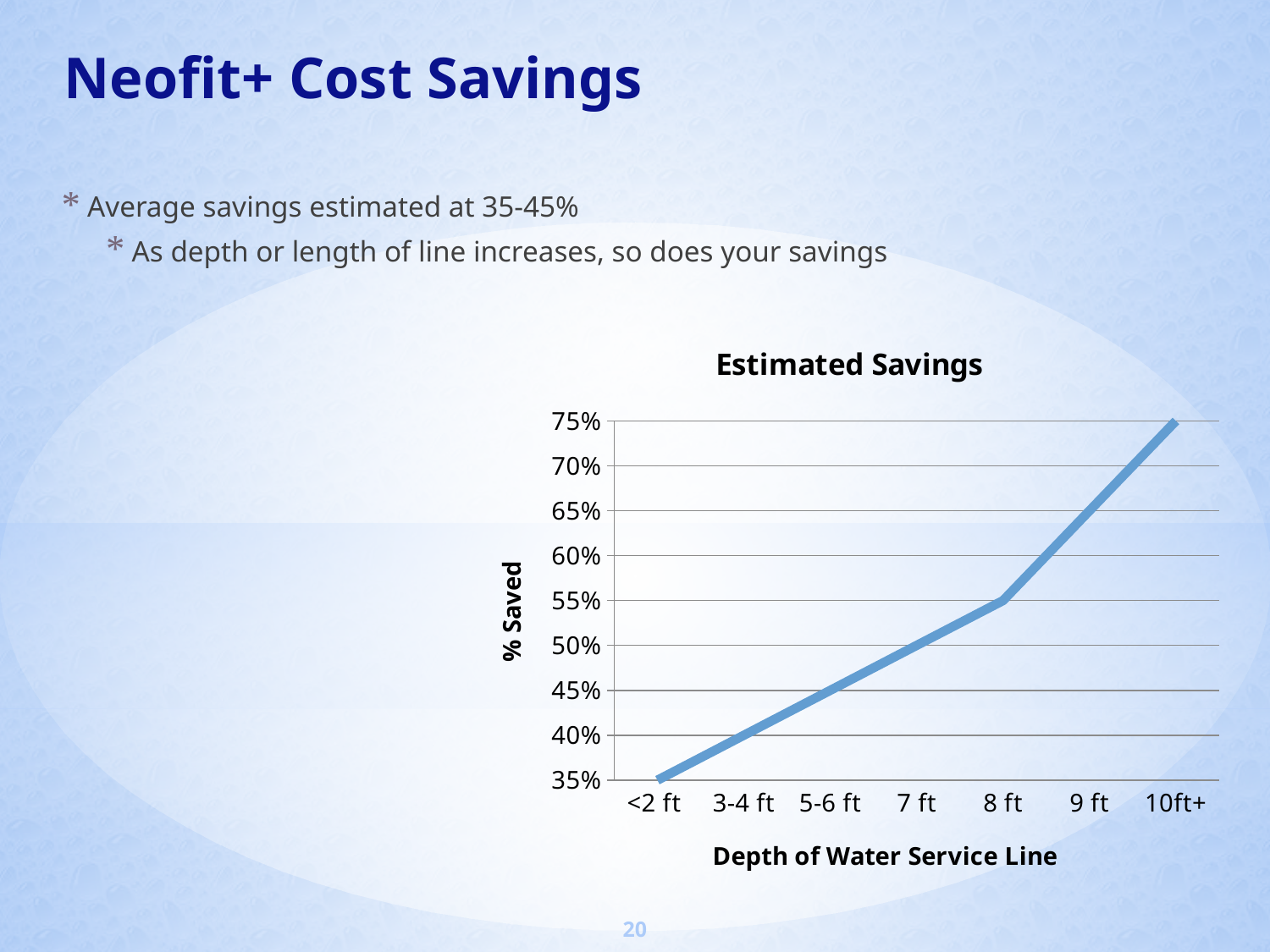
Which depth category has the highest % Saved? 10ft+ What is the % Saved value for the 10ft+ depth? 75% What kind of chart is shown on the slide? line chart What is the % Saved value for the <2 ft depth? 35% How many depth categories are plotted along the x axis? 7 What is the label of the x axis of the chart? Depth of Water Service Line Do the % Saved values rise or fall as the depth of the water service line increases? rise Which depth category has the lowest % Saved? <2 ft Is the % Saved value for 5-6 ft greater or less than 50%? less Is the % Saved value for 8 ft greater or less than 50%? greater Which has a larger % Saved, 9 ft or 7 ft? 9 ft What is the title of the chart? Estimated Savings